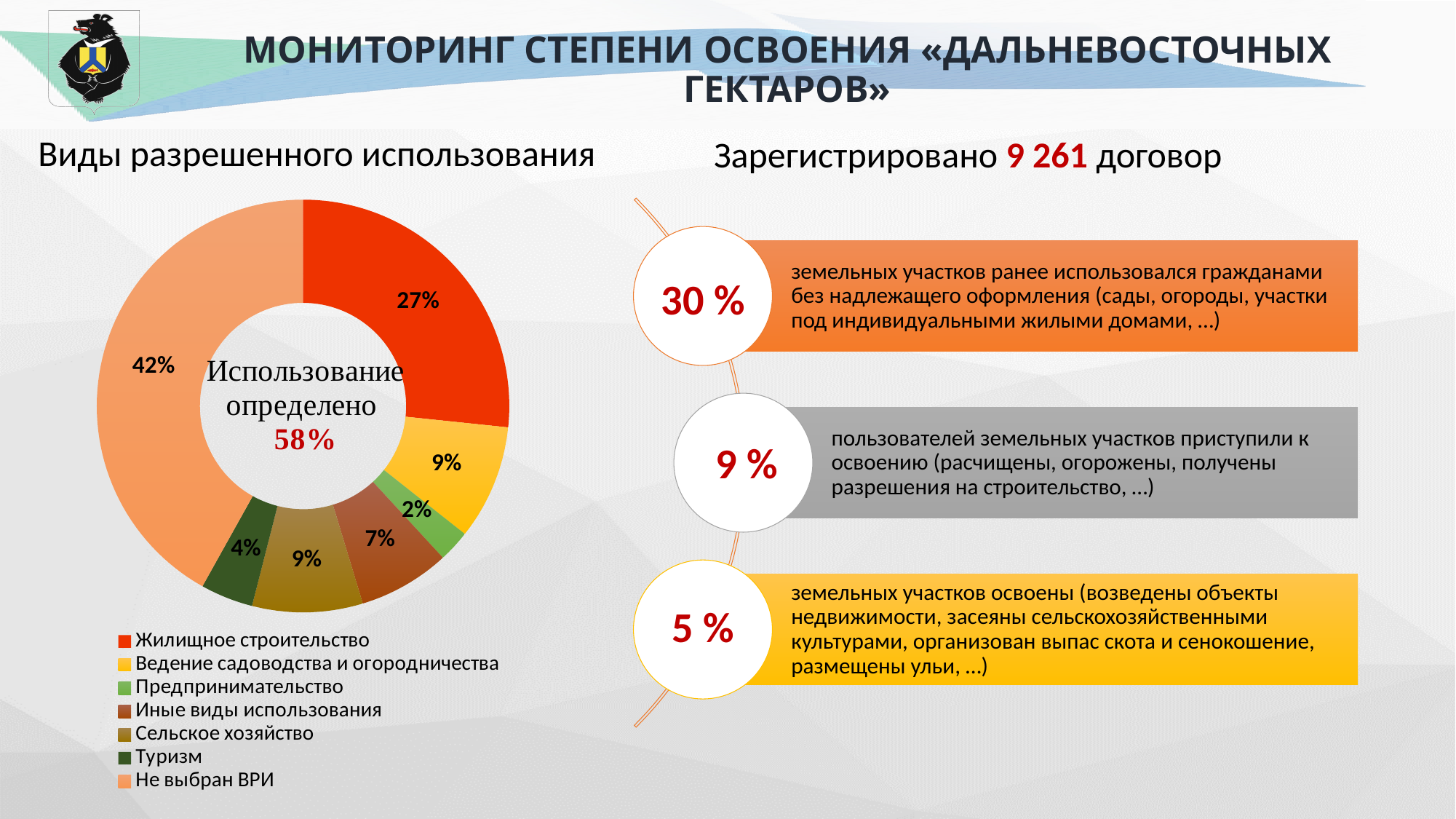
Which category has the smallest share in the donut chart? Предпринимательство Which is larger in the donut chart: "Иные виды использования" or "Туризм"? Иные виды использования What percentage is printed in the centre of the donut chart next to "Использование определено"? 58% What share of the donut chart is "Жилищное строительство"? 27% What share of the donut chart is "Иные виды использования"? 7% How many percentage points larger is "Не выбран ВРИ" than "Жилищное строительство" in the donut chart? 15% What share of the donut chart is "Предпринимательство"? 2% How many categories does the legend of the donut chart list? 7 What kind of chart is shown under "Виды разрешенного использования"? Donut (pie) chart What share of the donut chart is "Не выбран ВРИ"? 42% What share of the donut chart is "Туризм"? 4% Which category has the largest share in the donut chart? Не выбран ВРИ